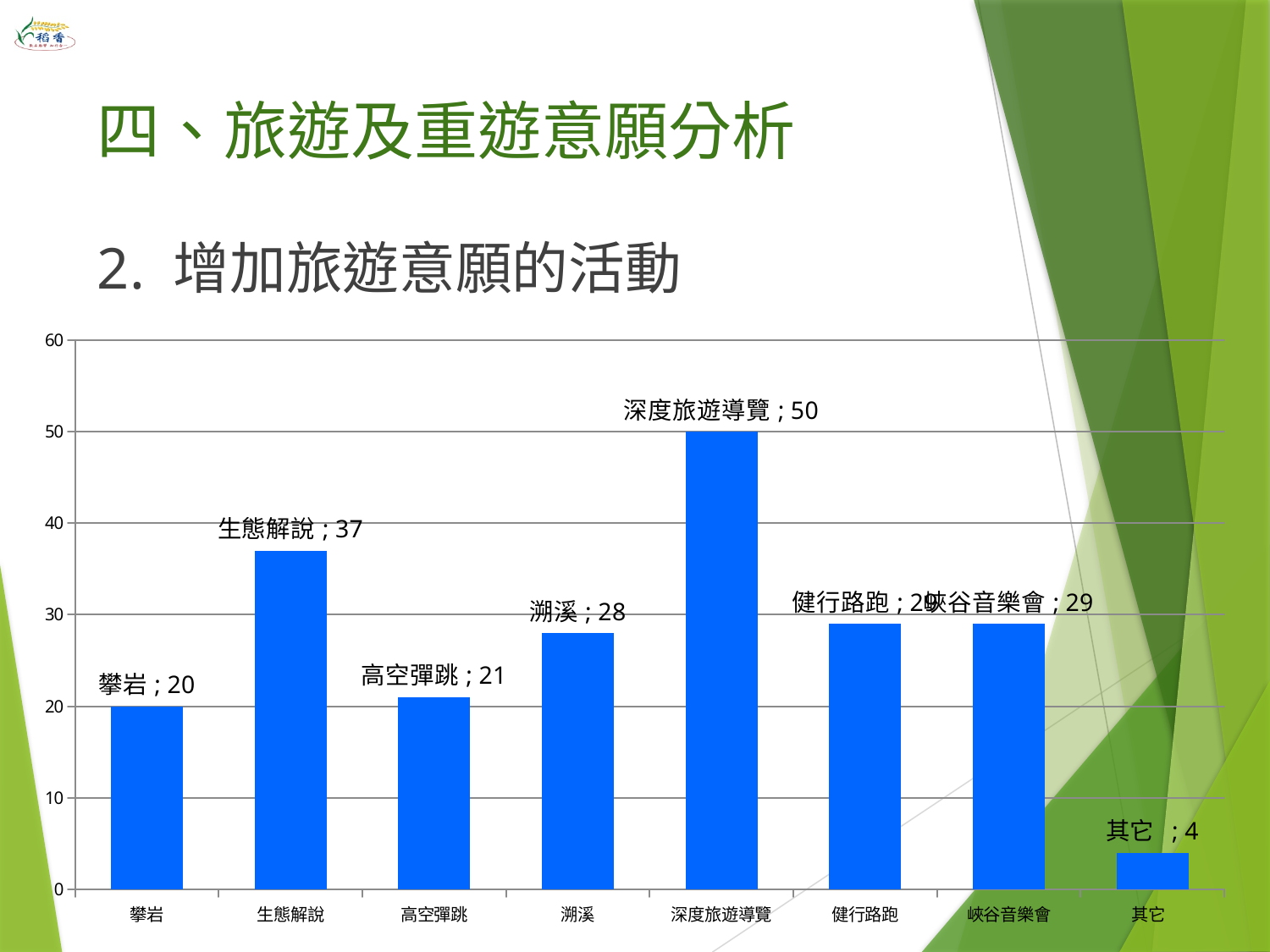
What is the value for 深度旅遊導覽? 50 What is the value for 其它? 4 Is the value for 健行路跑 greater or less than 20? greater Which is larger, the value for 溯溪 or the value for 高空彈跳? 溯溪 What is the value for 生態解說? 37 What is the difference between the values for 深度旅遊導覽 and 生態解說? 13 Which category has the highest value? 深度旅遊導覽 What is the value for 攀岩? 20 What is the value for 峽谷音樂會? 29 Which category has the lowest value? 其它 What is the difference between the values for 溯溪 and 攀岩? 8 How many categories are shown on the x axis? 8